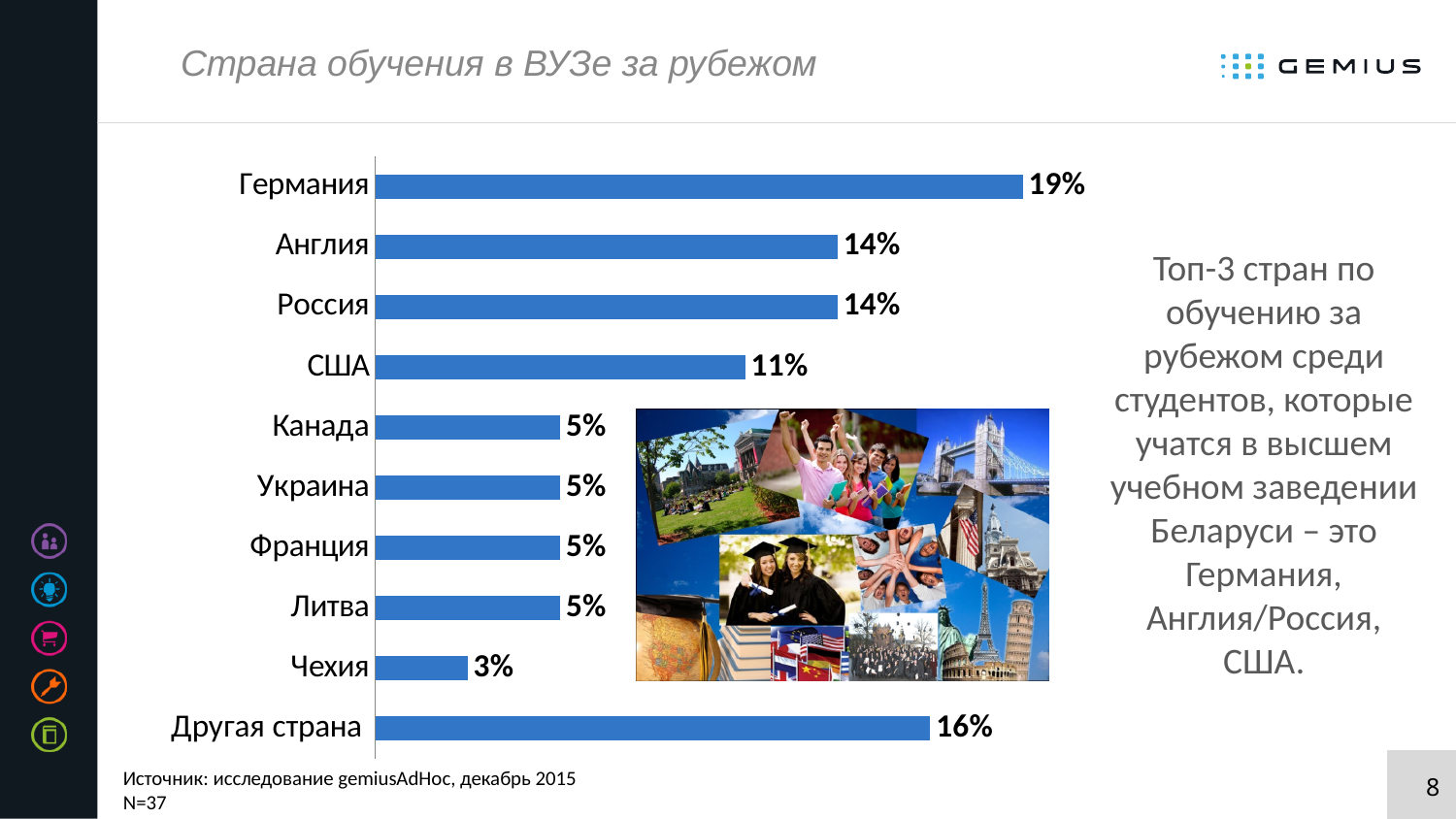
What is the difference between the values for Германия and Англия? 5% Which category has the lowest value? Чехия What is the difference between the values for Другая страна and США? 5% What is the value for Другая страна? 16% How many categories are shown in the chart? 10 What kind of chart is shown on the slide? Bar chart What is the value for США? 11% What is the value for Германия? 19% What is the value for Чехия? 3% Which category has the highest value? Германия What is the title of the slide? Страна обучения в ВУЗе за рубежом Which is larger, the value for Россия or the value for Канада? Россия